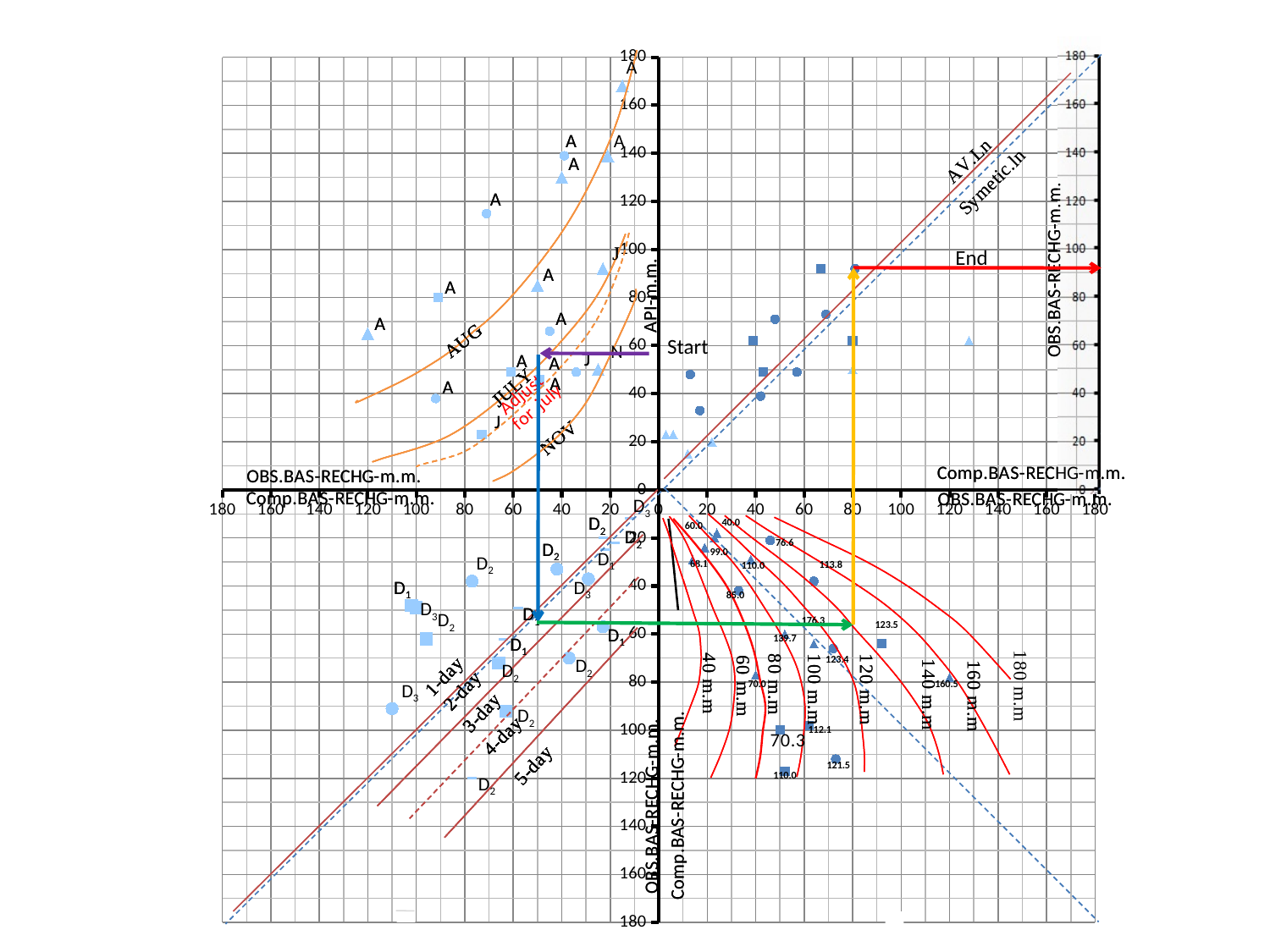
How many labelled curves (in m.m) are drawn in the bottom-right quadrant? 8 What is the largest m.m value labelled on a curve in the bottom-right quadrant? 180 m.m What kind of chart is shown on the slide? scatter chart How many month-labelled curves (AUG, JULY, NOV) are drawn in the top-left quadrant? 3 What is the label of the vertical axis in the top-left quadrant? API-m.m. What is the maximum value shown on each axis of the chart? 180 What is the lowest data label printed on a point in the bottom-right quadrant? 40.0 What is the smallest m.m value labelled on a curve in the bottom-right quadrant? 40 m.m What is the highest data label printed on a point in the bottom-right quadrant? 176.3 What are the two lines labelled in the top-right quadrant? AV.Ln and Symetic.ln How many day-labelled lines (1-day to 5-day) are drawn in the bottom-left quadrant? 5